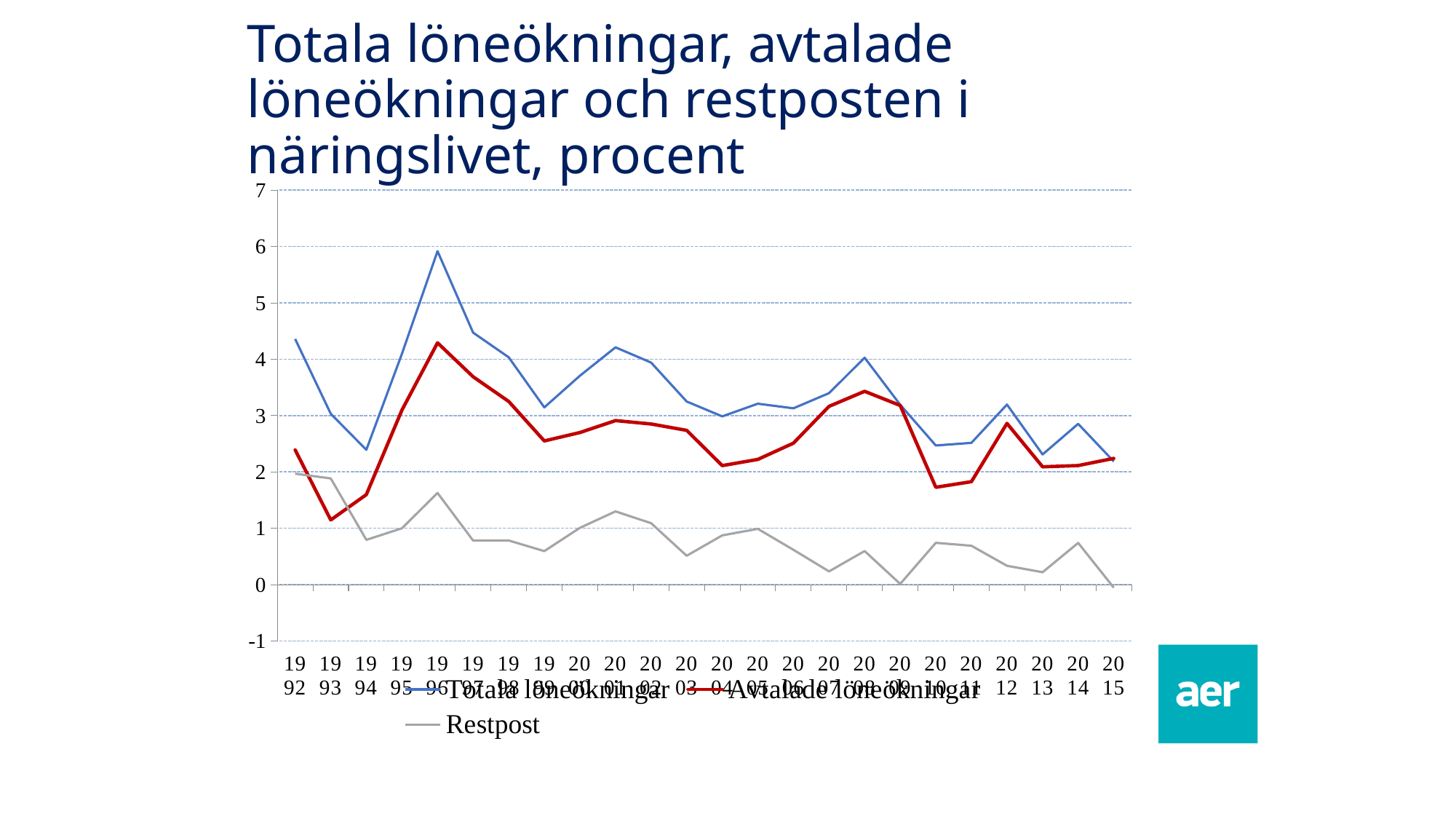
Does Totala löneökningar rise or fall from 1996 to 1999? fall In which year does Avtalade löneökningar reach its lowest value? 1993 What colour is the Restpost line? grey Is the value for Restpost in 1996 greater or less than 1? greater Is the value for Avtalade löneökningar in 1993 greater or less than 2? less How many years are plotted along the x axis? 24 Is the value for Avtalade löneökningar in 2010 greater or less than 2? less How many series does the legend list? 3 What kind of chart is shown on the slide? line chart In 1996, which is larger: Totala löneökningar or Avtalade löneökningar? Totala löneökningar In which year does Totala löneökningar reach its highest value? 1996